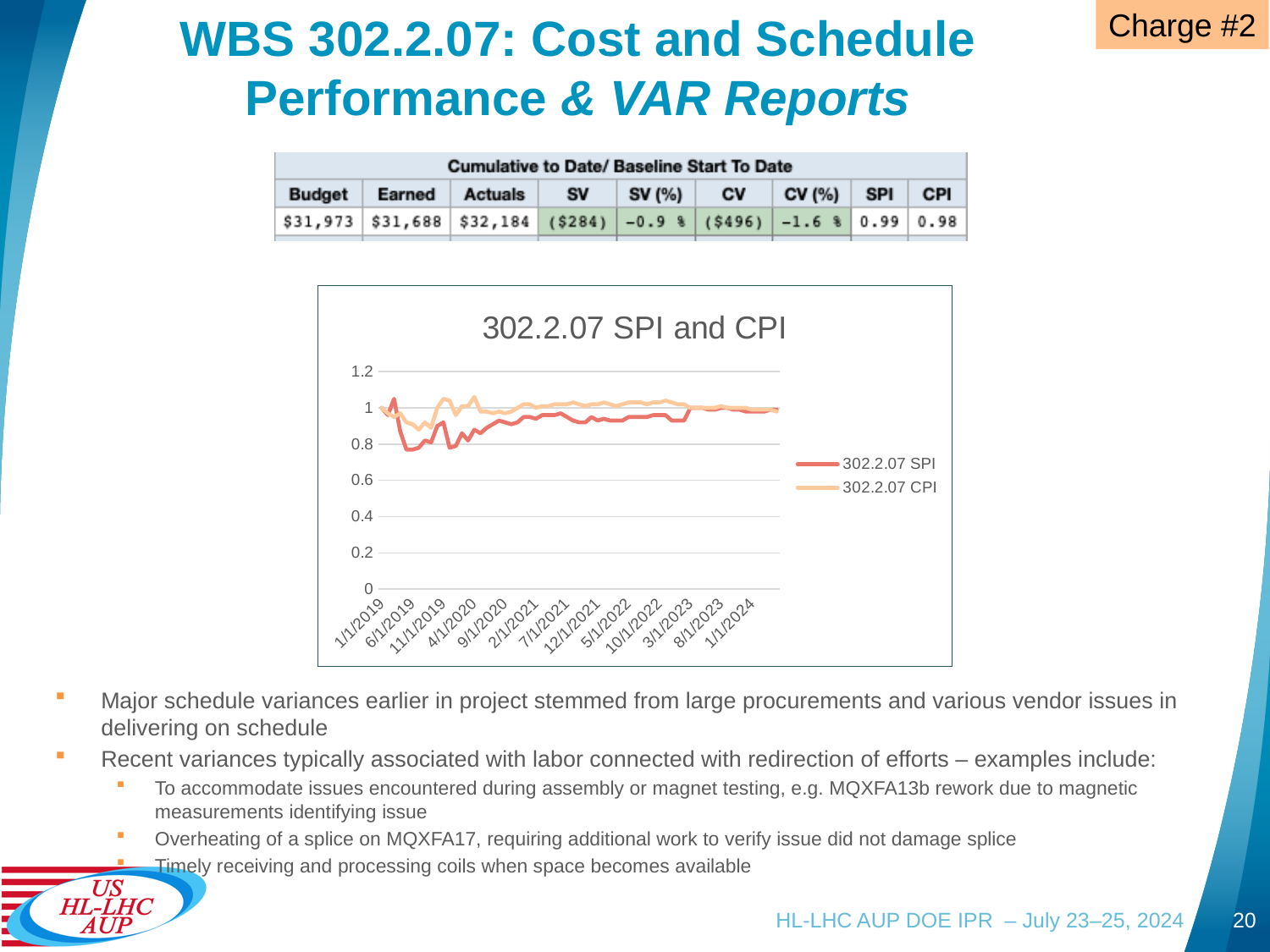
Around 2/1/2021, which series is lower on the chart, 302.2.07 SPI or 302.2.07 CPI? 302.2.07 SPI How many date labels are shown along the x axis of the chart? 13 How many series does the chart legend list? 2 Is the value of the 302.2.07 CPI series at 1/1/2024 greater or less than 0.6? greater Does the 302.2.07 SPI series generally rise or fall from mid-2019 to 1/1/2024? Rise What is the highest value shown on the chart's y axis? 1.2 Is the value of the 302.2.07 SPI series around 4/1/2020 greater or less than 1? less What kind of chart is shown on the slide? Line chart Is the value of the 302.2.07 SPI series at 1/1/2024 greater or less than 0.8? greater What are the two series named in the chart legend? 302.2.07 SPI and 302.2.07 CPI Which series on the chart dips lowest during 2019? 302.2.07 SPI What is the title of the chart? 302.2.07 SPI and CPI